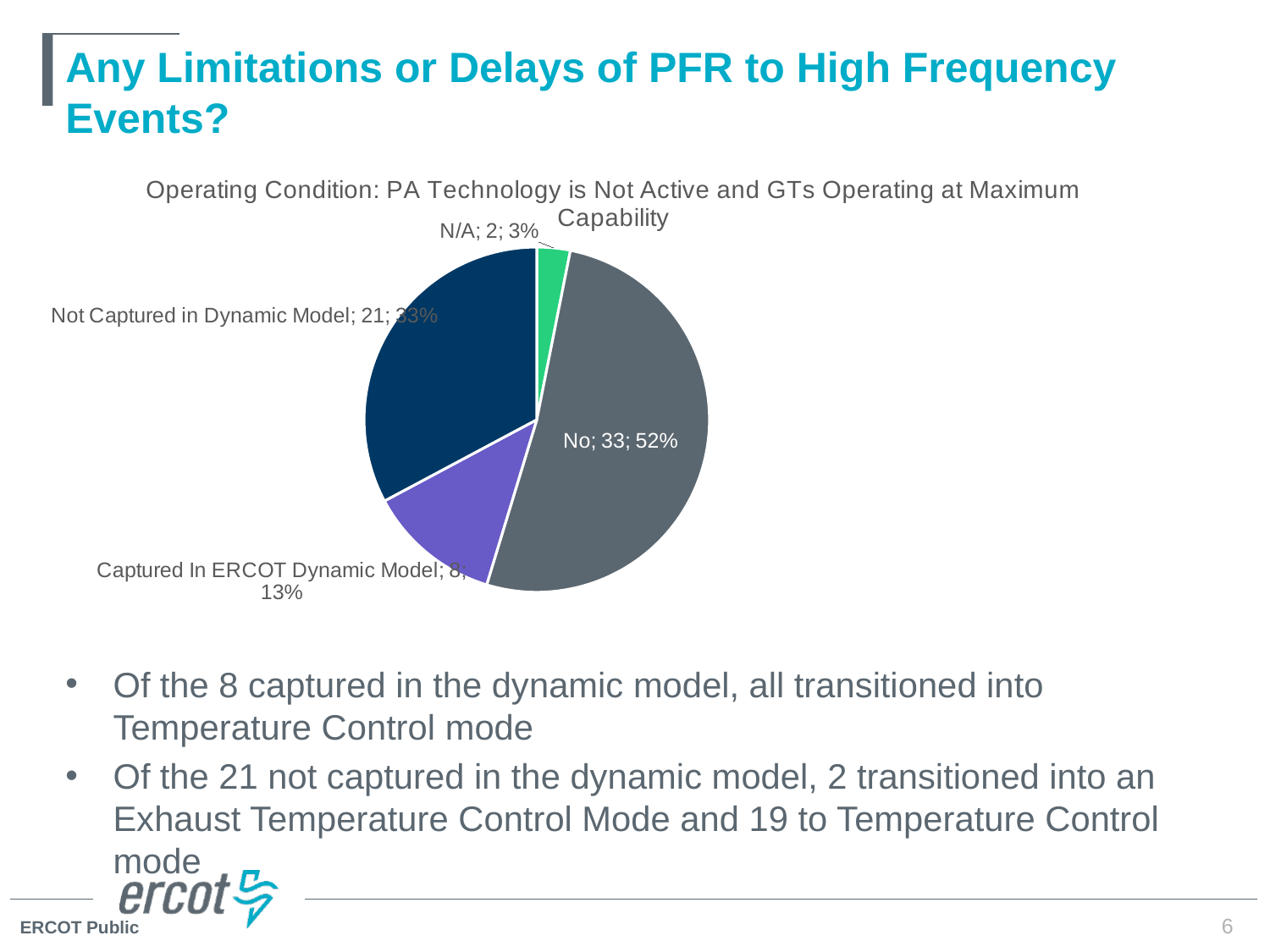
What kind of chart is shown on the slide? Pie chart Which slice of the pie chart is the largest? No What is the title of the pie chart? Operating Condition: PA Technology is Not Active and GTs Operating at Maximum Capability Which slice of the pie chart is the smallest? N/A What is the count for "Not Captured in Dynamic Model"? 21 How many slices does the pie chart have? 4 What percentage share does "Captured In ERCOT Dynamic Model" represent? 13% What is the count for the "N/A" slice? 2 What is the count for the "No" slice in the pie chart? 33 What percentage share does the "No" slice represent? 52% Which has a larger count, "Captured In ERCOT Dynamic Model" or "Not Captured in Dynamic Model"? Not Captured in Dynamic Model What is the difference in count between "No" and "Not Captured in Dynamic Model"? 12